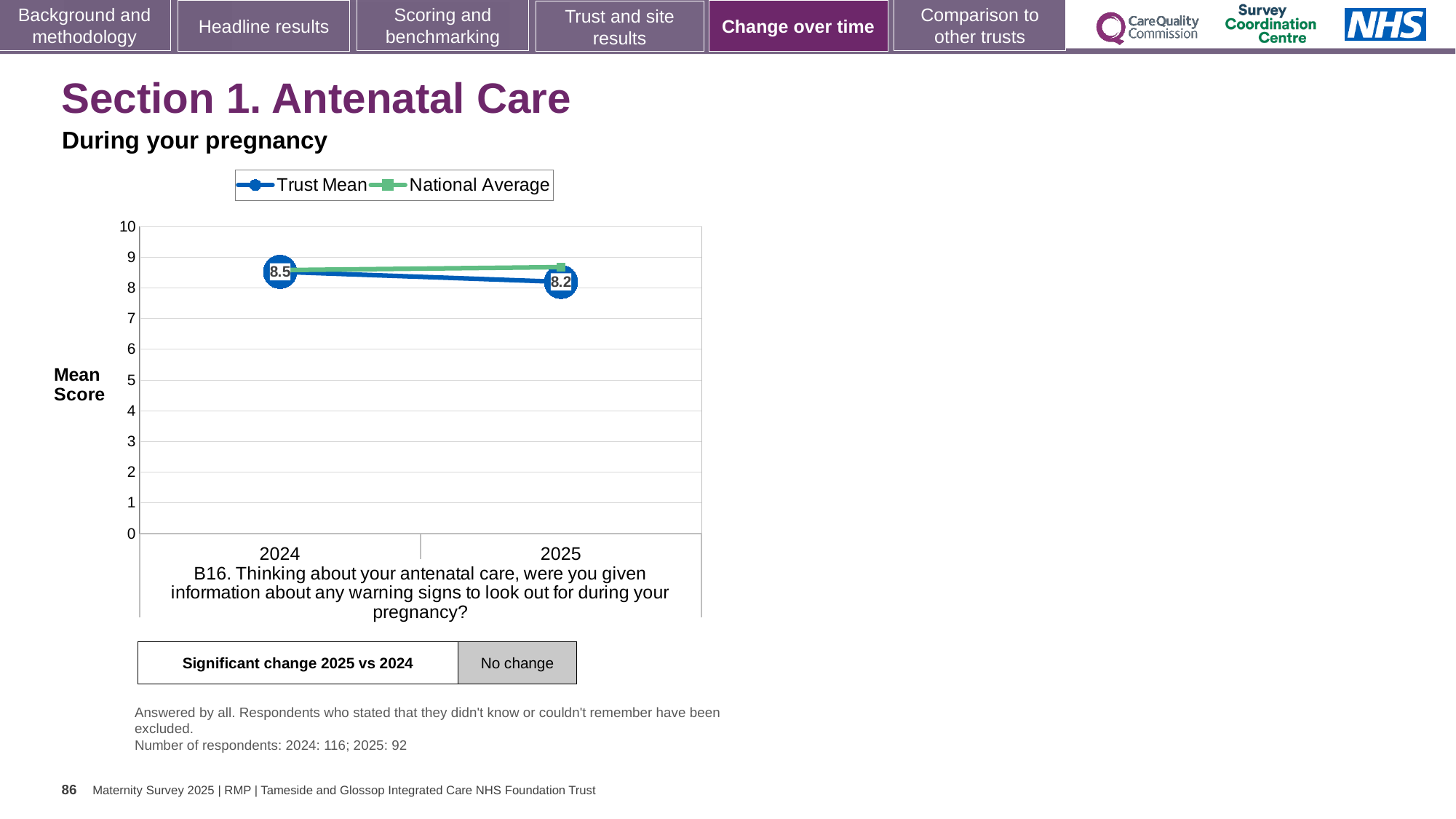
In 2025, which is higher, the Trust Mean or the National Average? National Average How many years are plotted on the x axis? 2 What kind of chart is shown on the slide? line chart Is the National Average value for 2025 greater or less than 8? greater What is the Trust Mean value for 2024? 8.5 What is the label on the y axis of the chart? Mean Score Does the Trust Mean rise or fall from 2024 to 2025? fall Which year has the higher Trust Mean, 2024 or 2025? 2024 By how much did the Trust Mean change between 2024 and 2025? -0.3 How many series does the legend list? 2 What is the Trust Mean value for 2025? 8.2 What are the two series named in the legend? Trust Mean and National Average